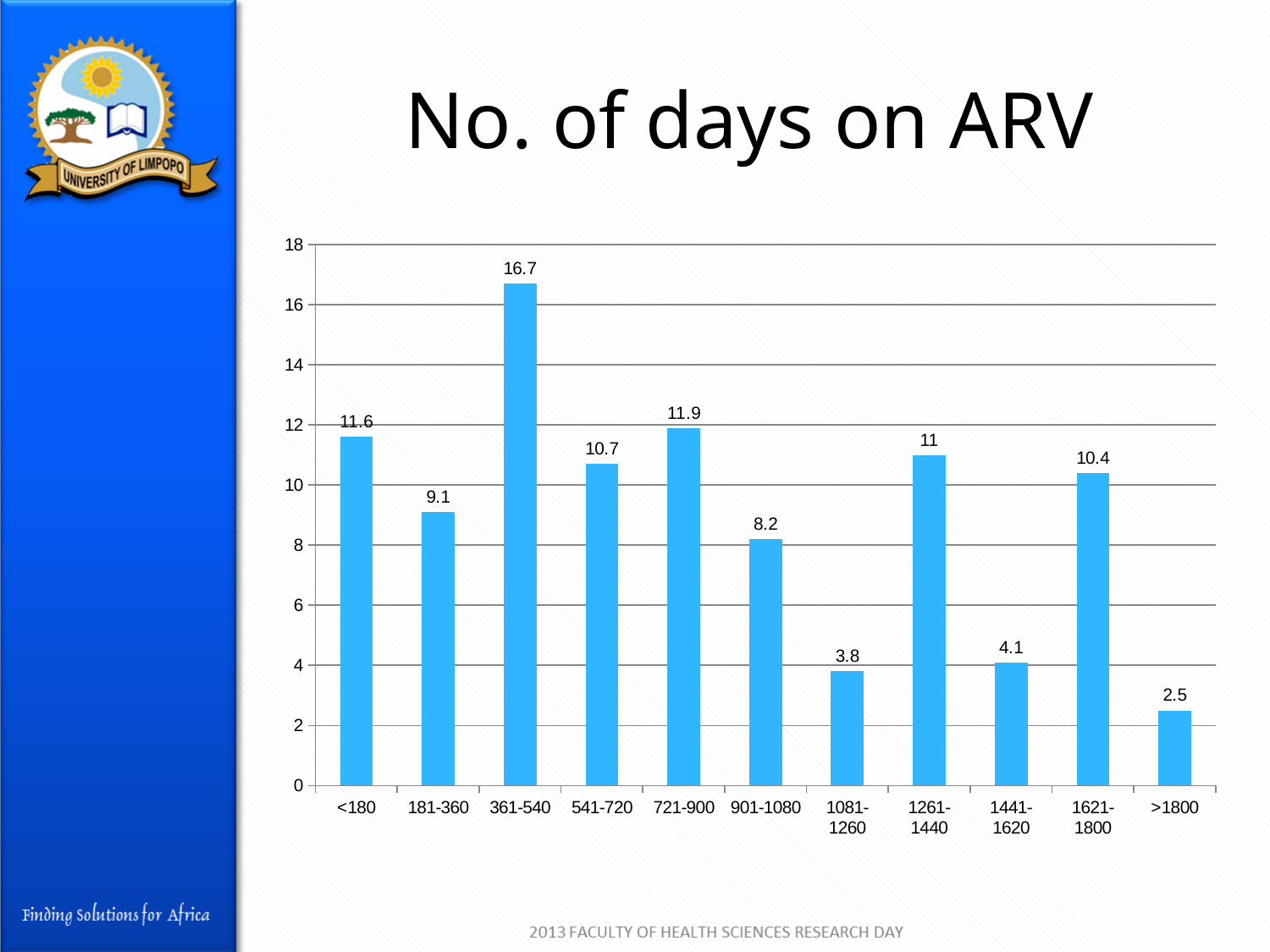
How many categories are shown on the x axis? 11 What is the value for the 1261-1440 category? 11 Which category has the highest value? 361-540 What kind of chart is shown on the slide? bar chart Is the value for 901-1080 greater or less than 10? less What is the value for the 361-540 category? 16.7 What is the difference between the values for 361-540 and 181-360? 7.6 What is the difference between the values for 1441-1620 and 1081-1260? 0.3 Which is larger, the value for <180 or the value for 721-900? 721-900 Which category has the lowest value? >1800 What is the title of the slide? No. of days on ARV What is the value for the >1800 category? 2.5